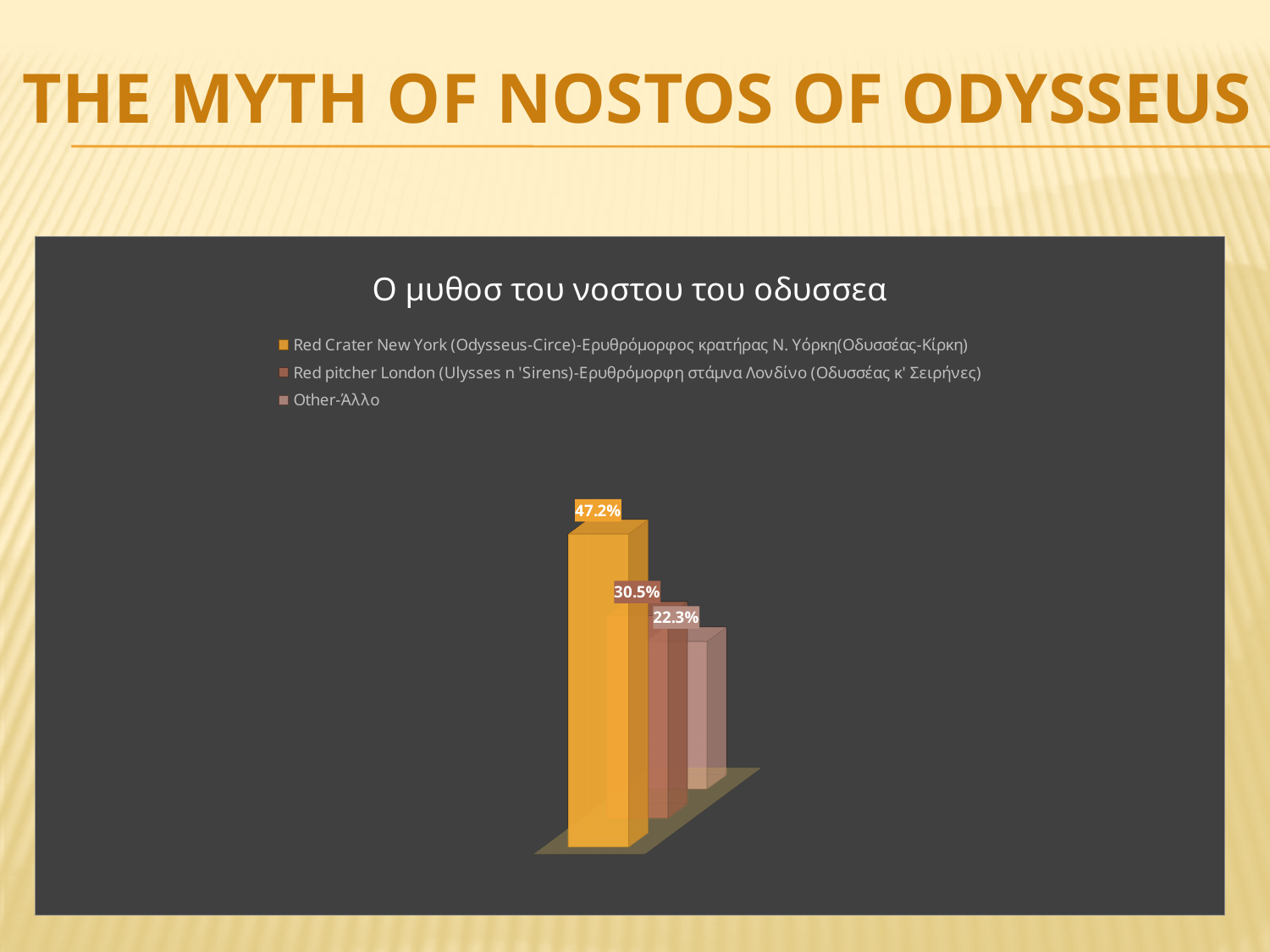
What is the difference between the values for Red pitcher London and Other-Άλλο? 8.2% What is the value for Other-Άλλο? 22.3% Which series has the highest value? Red Crater New York (Odysseus-Circe) What is the value for Red Crater New York (Odysseus-Circe)? 47.2% What kind of chart is shown on the slide? Bar chart How many series does the legend list? 3 What is the difference between the values for Red Crater New York and Red pitcher London? 16.7% What is the value for Red pitcher London (Ulysses n 'Sirens)? 30.5% What is the total of the three values shown on the chart? 100% Which series has the lowest value? Other-Άλλο Which is larger, the value for Red pitcher London or the value for Other-Άλλο? Red pitcher London What is the title of the chart? Ο μυθοσ του νοστου του οδυσσεα